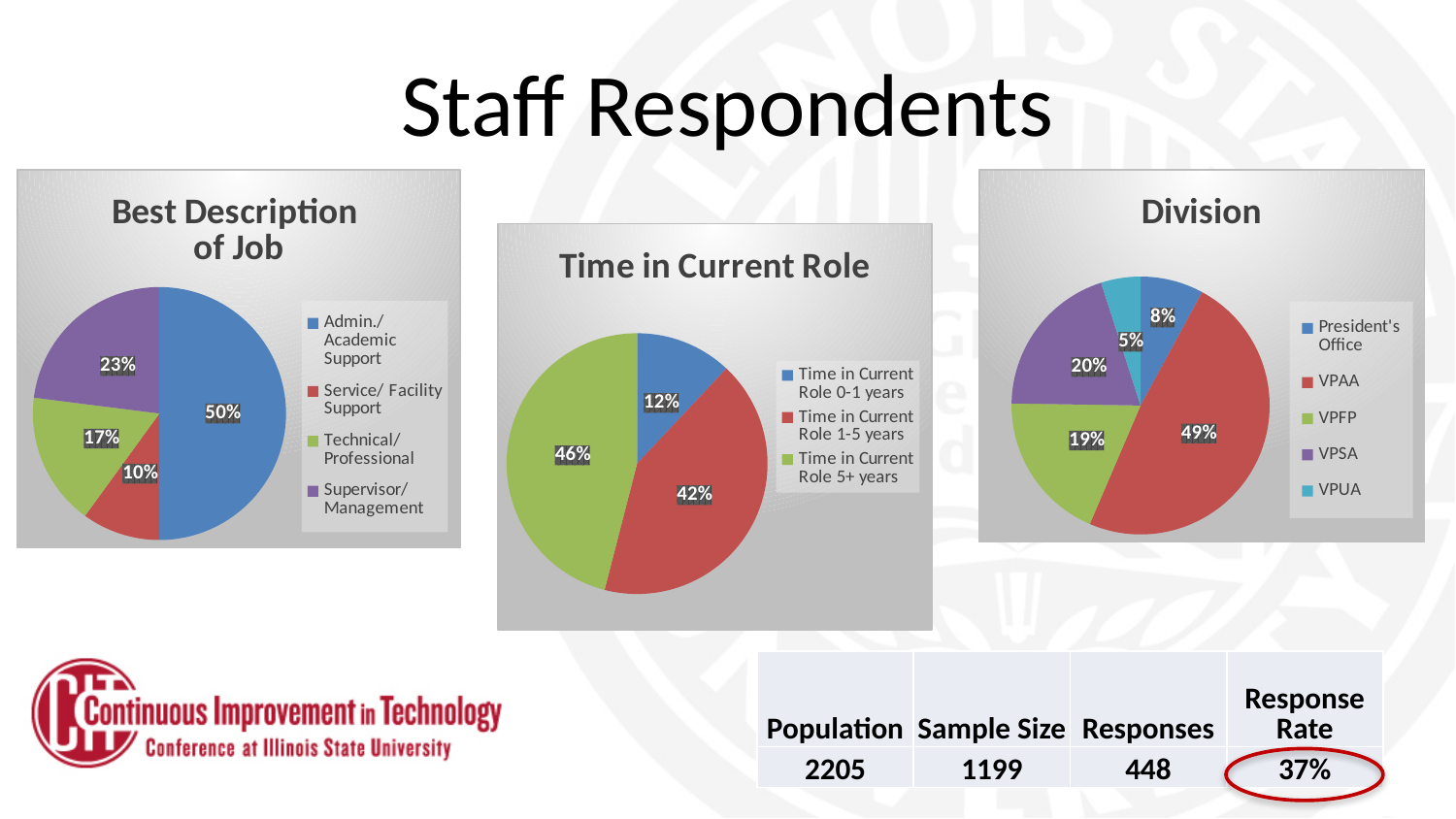
What kind of chart is the 'Time in Current Role' chart? Pie chart In the 'Best Description of Job' chart, what share of respondents are Admin./Academic Support? 50% In the 'Division' chart, which division has the smallest slice? VPUA In the 'Time in Current Role' chart, which is larger: the 0-1 years slice or the 1-5 years slice? Time in Current Role 1-5 years In the 'Best Description of Job' chart, which category has the smallest slice? Service/ Facility Support In the 'Best Description of Job' chart, what is the difference between the Supervisor/Management and Technical/Professional shares? 6% In the 'Time in Current Role' chart, which category has the largest slice? Time in Current Role 5+ years How many entries does the legend of the 'Division' chart list? 5 In the 'Time in Current Role' chart, what share of respondents have been in their role 5+ years? 46% In the 'Division' chart, what share of respondents are from VPAA? 49% How many categories does the 'Best Description of Job' chart show? 4 In the 'Division' chart, what is the difference between the VPSA and President's Office shares? 12%